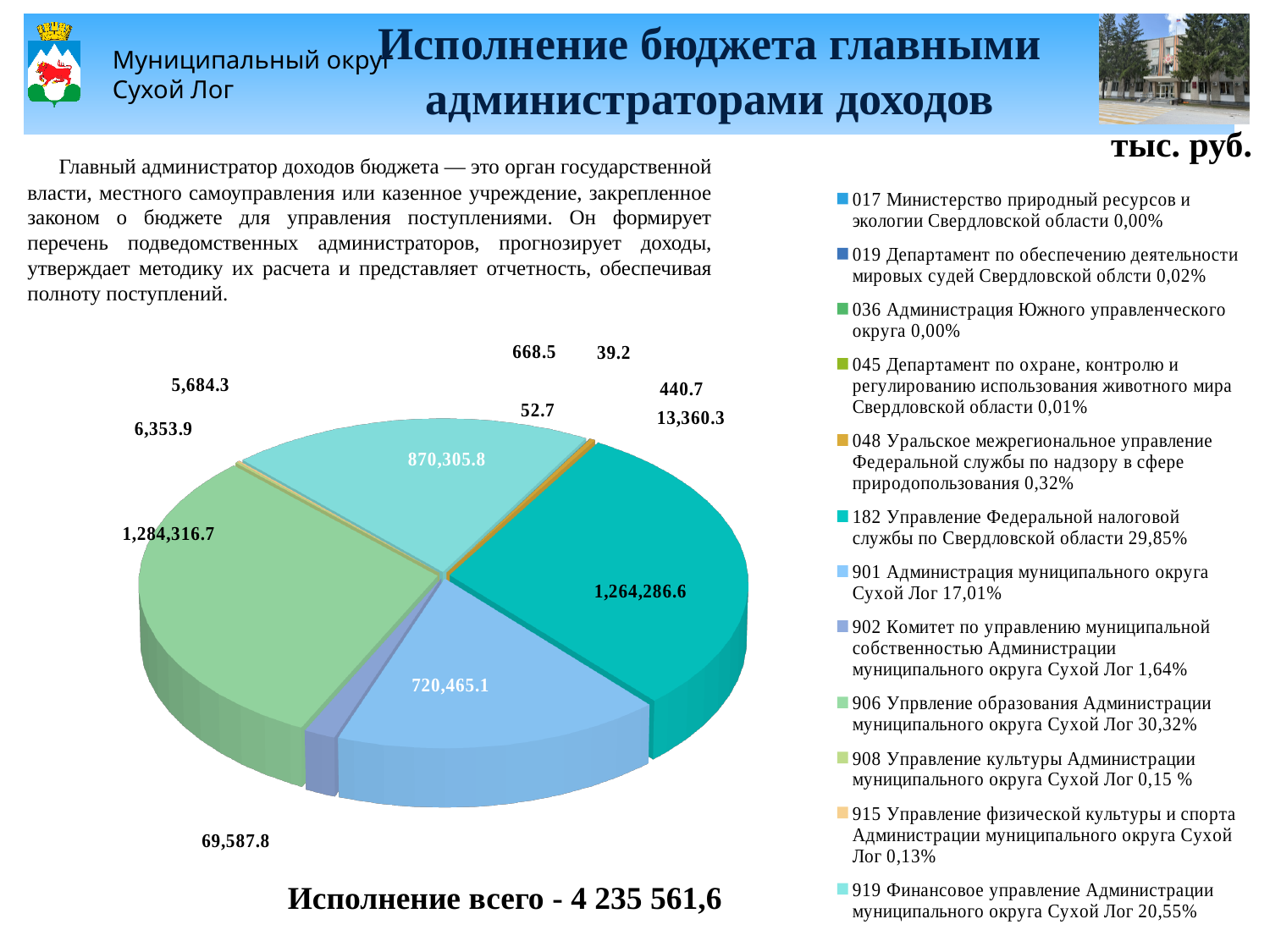
What is the smallest value labelled on the pie chart? 39.2 What is the largest value labelled on the pie chart? 1,284,316.7 According to the legend, what share of the total does 906 Управление образования Администрации муниципального округа Сухой Лог have? 30,32% What total execution amount (Исполнение всего) is printed below the chart? 4 235 561,6 According to the legend, what share does 919 Финансовое управление Администрации муниципального округа Сухой Лог have? 20,55% According to the legend, what share does 901 Администрация муниципального округа Сухой Лог have? 17,01% How many entries does the chart legend list? 12 What kind of chart is shown on the slide? pie chart What is the difference between the slice labelled 870,305.8 and the slice labelled 720,465.1? 149,840.7 What unit is indicated in the top right of the slide for the chart values? тыс. руб. Which is larger: the slice labelled 1,284,316.7 or the slice labelled 1,264,286.6? 1,284,316.7